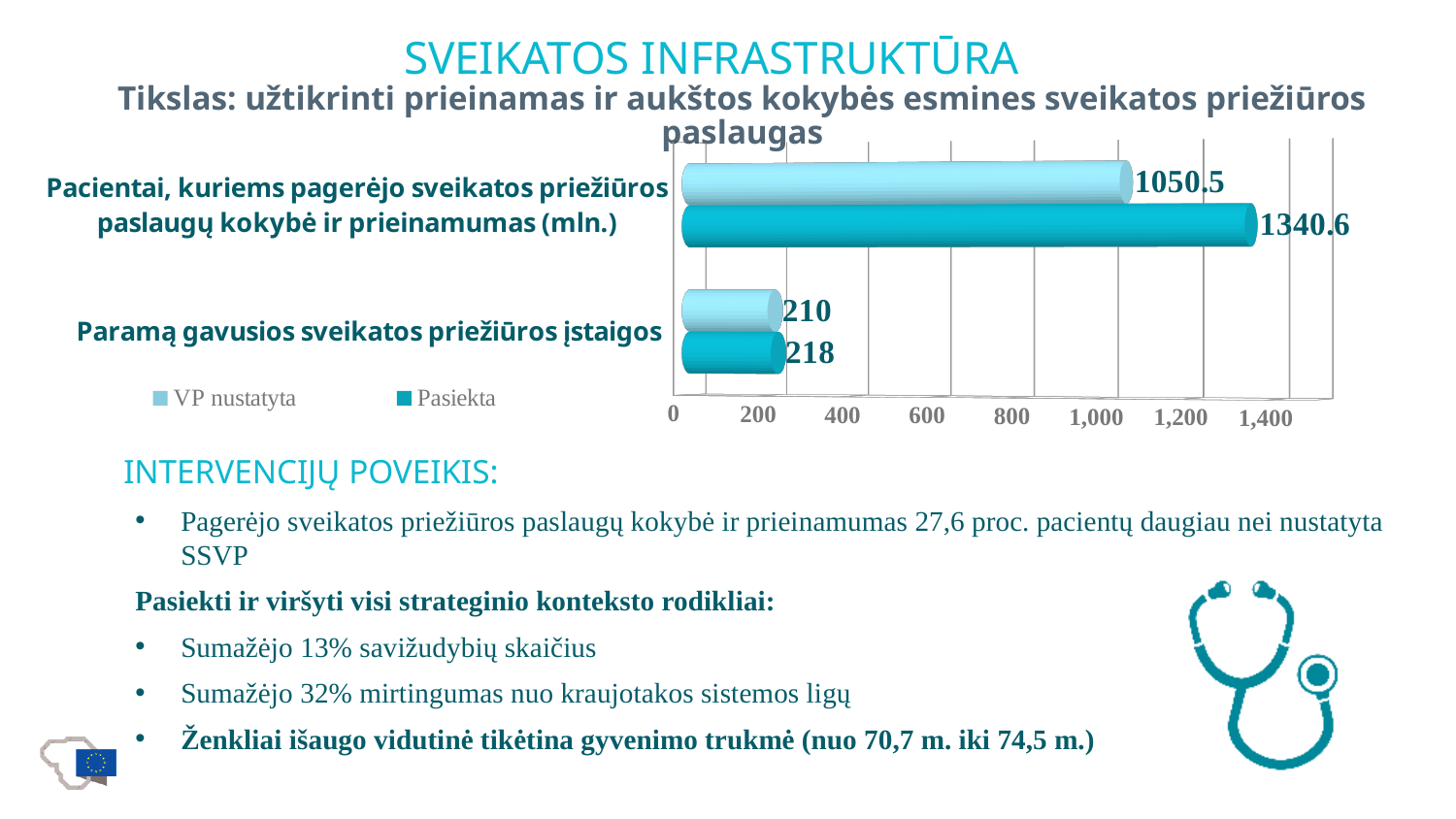
Which category has the highest 'Pasiekta' value? Pacientai, kuriems pagerėjo sveikatos priežiūros paslaugų kokybė ir prieinamumas (mln.) What is the 'Pasiekta' value for 'Paramą gavusios sveikatos priežiūros įstaigos'? 218 What is the 'VP nustatyta' value for 'Pacientai, kuriems pagerėjo sveikatos priežiūros paslaugų kokybė ir prieinamumas (mln.)'? 1050.5 What is the difference between the 'Pasiekta' and 'VP nustatyta' values for 'Paramą gavusios sveikatos priežiūros įstaigos'? 8 How many categories are shown in the chart? 2 What is the 'Pasiekta' value for 'Pacientai, kuriems pagerėjo sveikatos priežiūros paslaugų kokybė ir prieinamumas (mln.)'? 1340.6 Which category has the lowest 'VP nustatyta' value? Paramą gavusios sveikatos priežiūros įstaigos What is the 'VP nustatyta' value for 'Paramą gavusios sveikatos priežiūros įstaigos'? 210 Which is larger for 'Pacientai, kuriems pagerėjo sveikatos priežiūros paslaugų kokybė ir prieinamumas (mln.)': 'VP nustatyta' or 'Pasiekta'? Pasiekta What is the difference between the 'Pasiekta' and 'VP nustatyta' values for 'Pacientai, kuriems pagerėjo sveikatos priežiūros paslaugų kokybė ir prieinamumas (mln.)'? 290.1 How many series does the chart legend list? 2 What kind of chart is shown on the slide? Bar chart